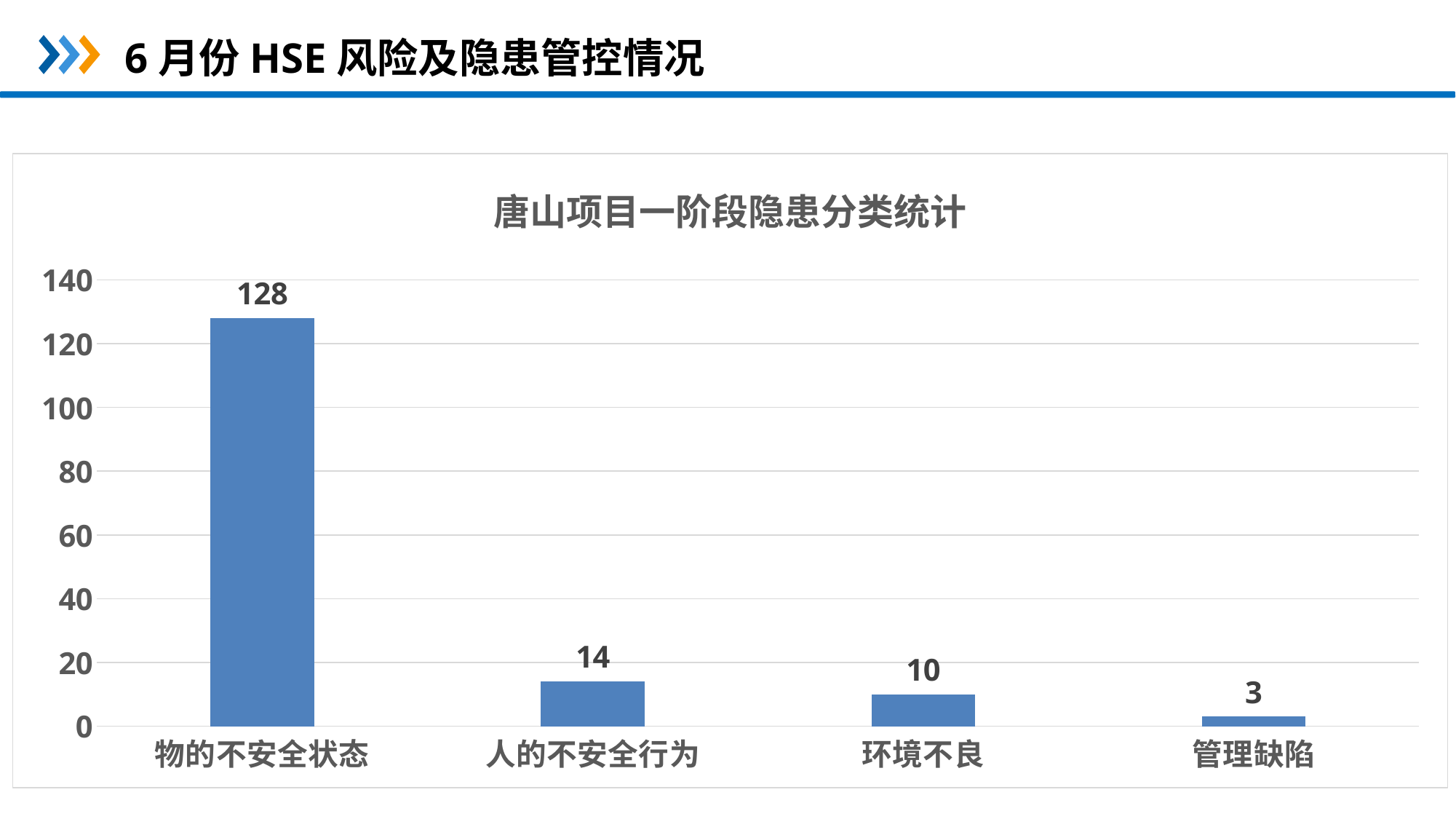
What is the value for 物的不安全状态? 128 What is the value for 环境不良? 10 What is the difference between the values for 环境不良 and 管理缺陷? 7 Is the value for 物的不安全状态 greater or less than 120? greater Which is larger, the value for 人的不安全行为 or the value for 环境不良? 人的不安全行为 What is the difference between the values for 物的不安全状态 and 人的不安全行为? 114 What kind of chart is shown on the slide? bar chart What is the value for 人的不安全行为? 14 Which category has the lowest value? 管理缺陷 Which category has the highest value? 物的不安全状态 What is the value for 管理缺陷? 3 How many categories are shown on the x axis? 4